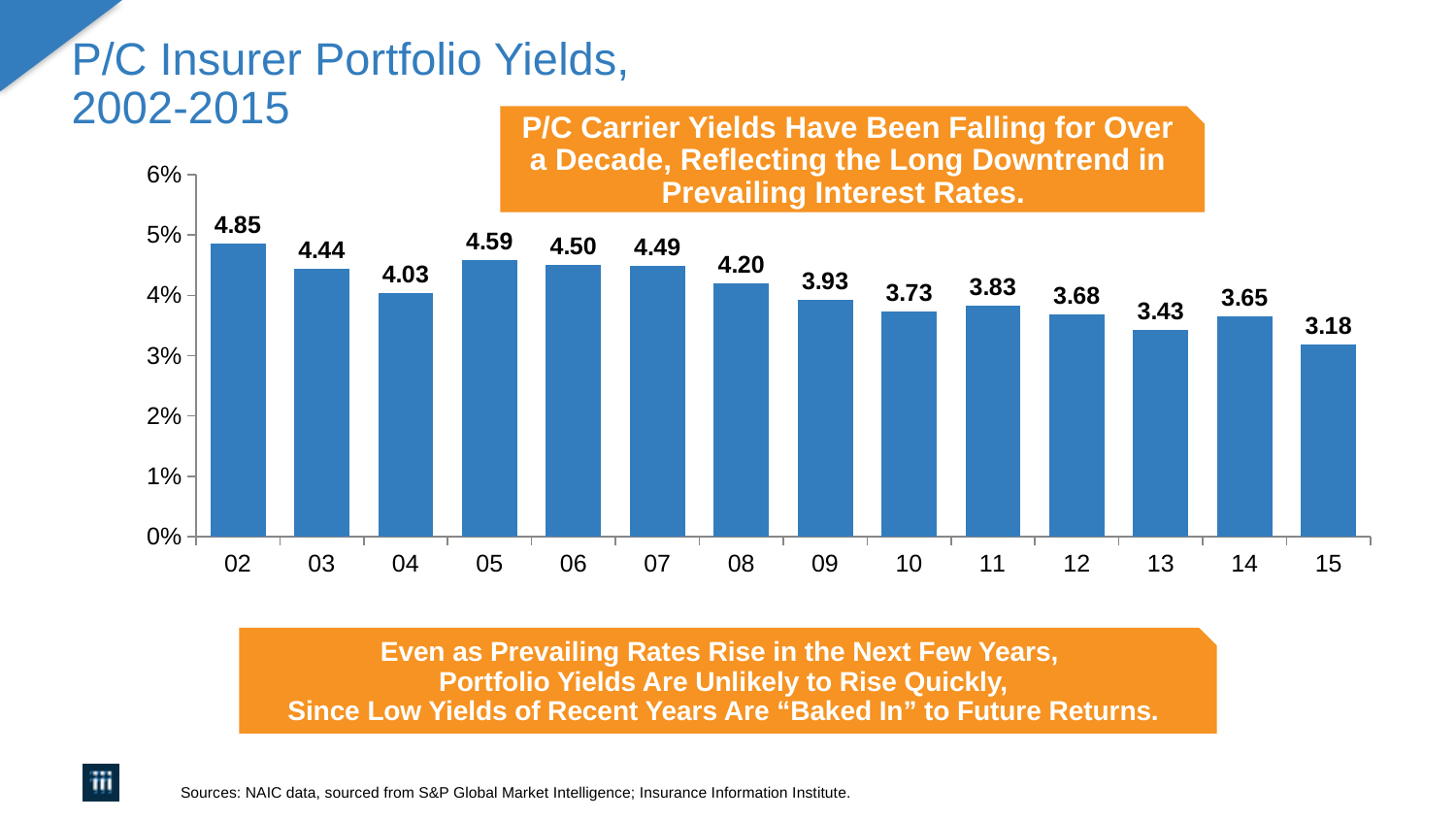
Is the value for 13 greater or less than 4%? less Which year has the highest portfolio yield? 02 What is the value shown for 09? 3.93 Do the portfolio yields generally rise or fall from 02 to 15? fall Which is larger, the value for 05 or the value for 08? 05 What is the title of the chart? P/C Insurer Portfolio Yields, 2002-2015 What is the portfolio yield value shown for 02? 4.85 What is the difference between the values for 02 and 15? 1.67 What is the portfolio yield value shown for 15? 3.18 What kind of chart is shown on the slide? bar chart How many years are shown on the x axis? 14 Which year has the lowest portfolio yield? 15